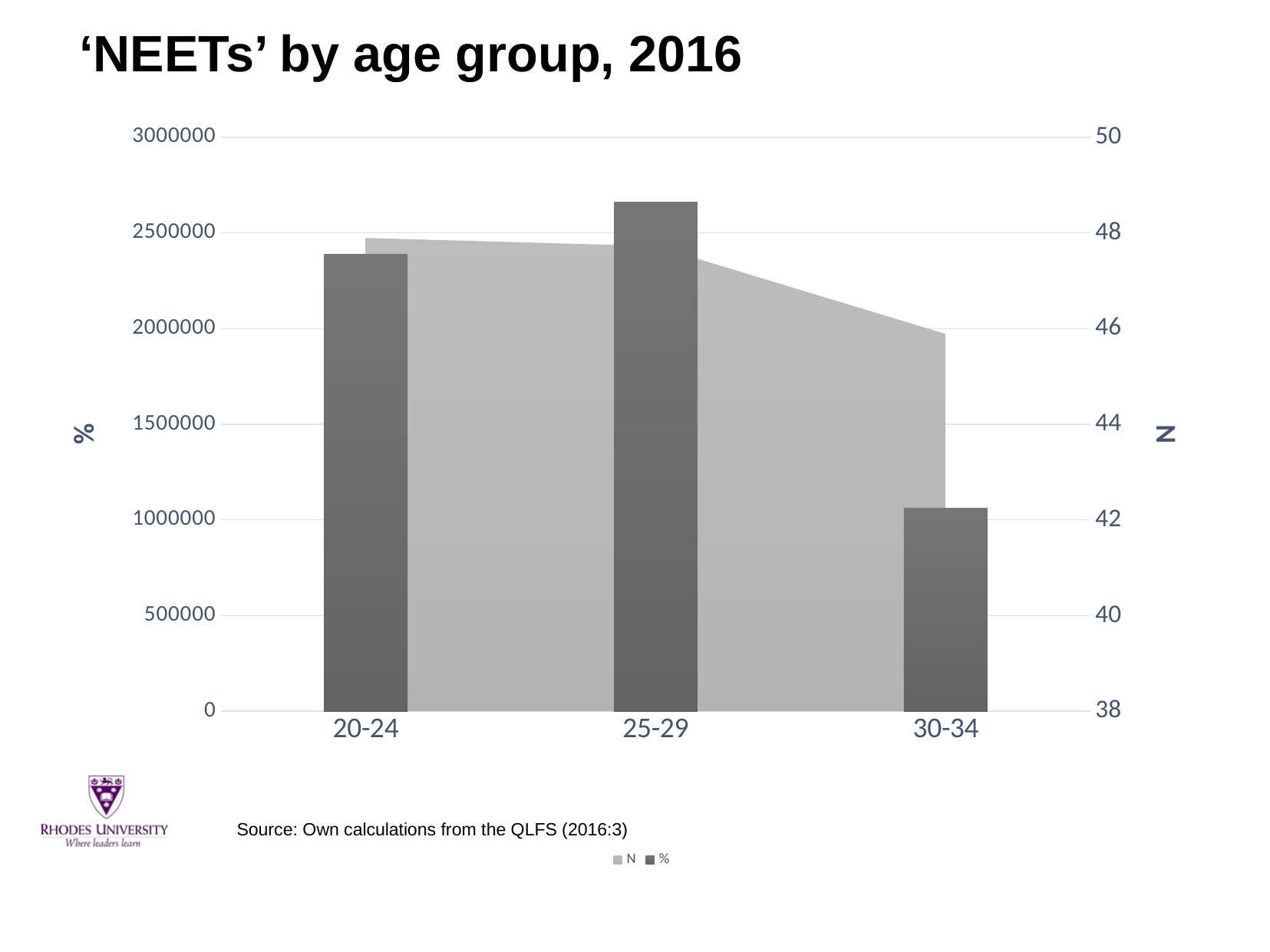
What are the two series named in the chart legend? N and % Does the shaded N area rise or fall from the 20-24 age group to the 30-34 age group? fall What is the title of the chart on the slide? ‘NEETs’ by age group, 2016 Which has the taller % bar, the 20-24 age group or the 30-34 age group? 20-24 Which age group has the shortest bar for the % series? 30-34 Is the % bar for the 25-29 age group greater or less than 48 on the right-hand axis? greater Is the % bar for the 30-34 age group greater or less than 44 on the right-hand axis? less Which age group has the tallest bar for the % series? 25-29 How many age groups are shown on the x axis of the chart? 3 How many series does the chart legend list? 2 Is the % bar for the 20-24 age group greater or less than 46 on the right-hand axis? greater